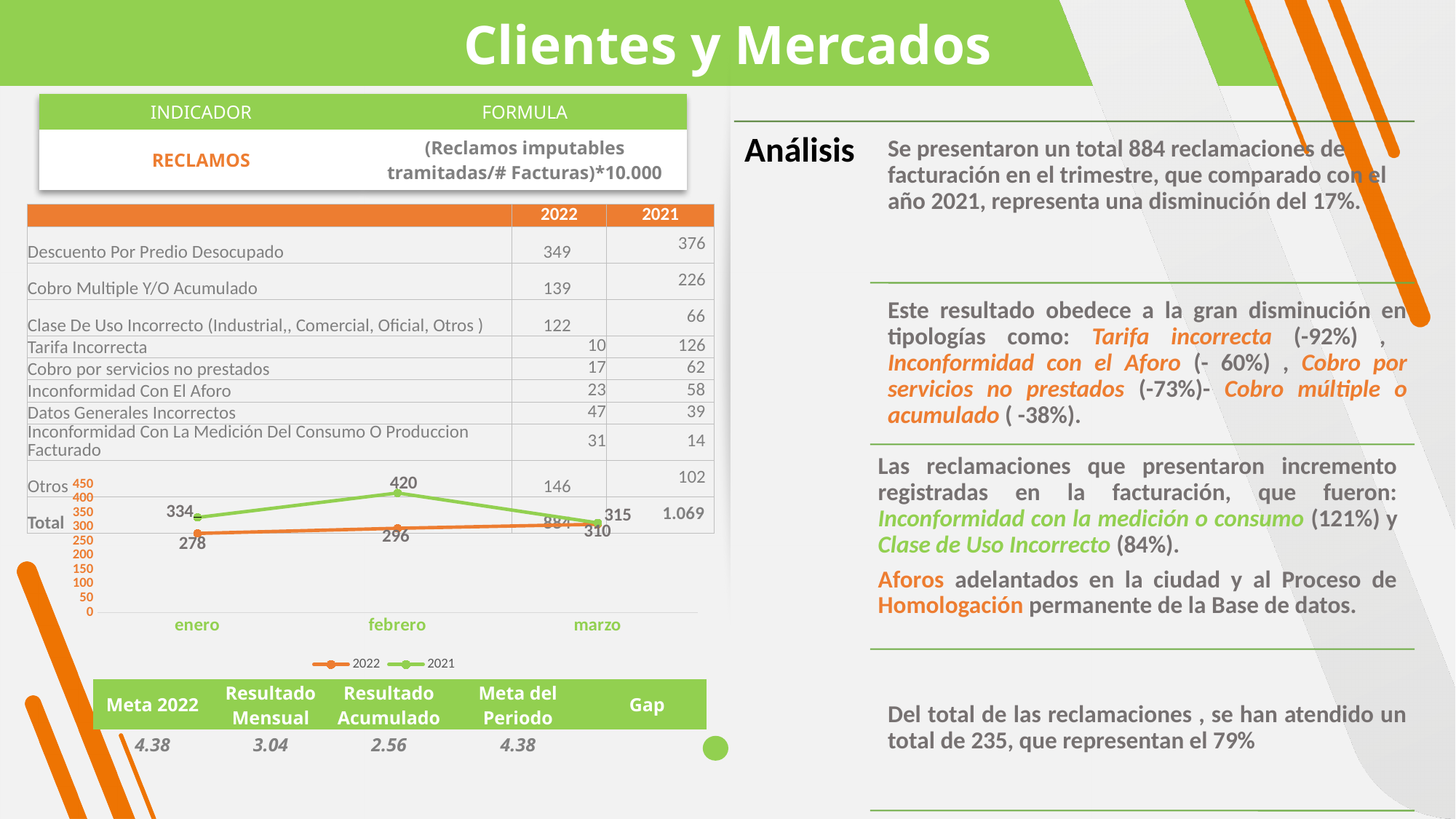
In the line chart, what is the value for 2021 in enero? 334 In the line chart, what is the value for 2021 in febrero? 420 In the line chart, what is the value for 2022 in febrero? 296 How many series does the legend of the line chart list? 2 In the line chart, which series has the larger value in enero, 2022 or 2021? 2021 In the line chart, which month has the highest value for the 2021 series? febrero How many months are plotted on the x axis of the line chart? 3 In the line chart, what is the value for 2022 in marzo? 310 In the line chart, what is the difference between the 2021 and 2022 values in febrero? 124 In the line chart, do the values for the 2022 series rise or fall from enero to marzo? rise In the line chart, which month has the lowest value for the 2022 series? enero What kind of chart is shown on the slide? line chart